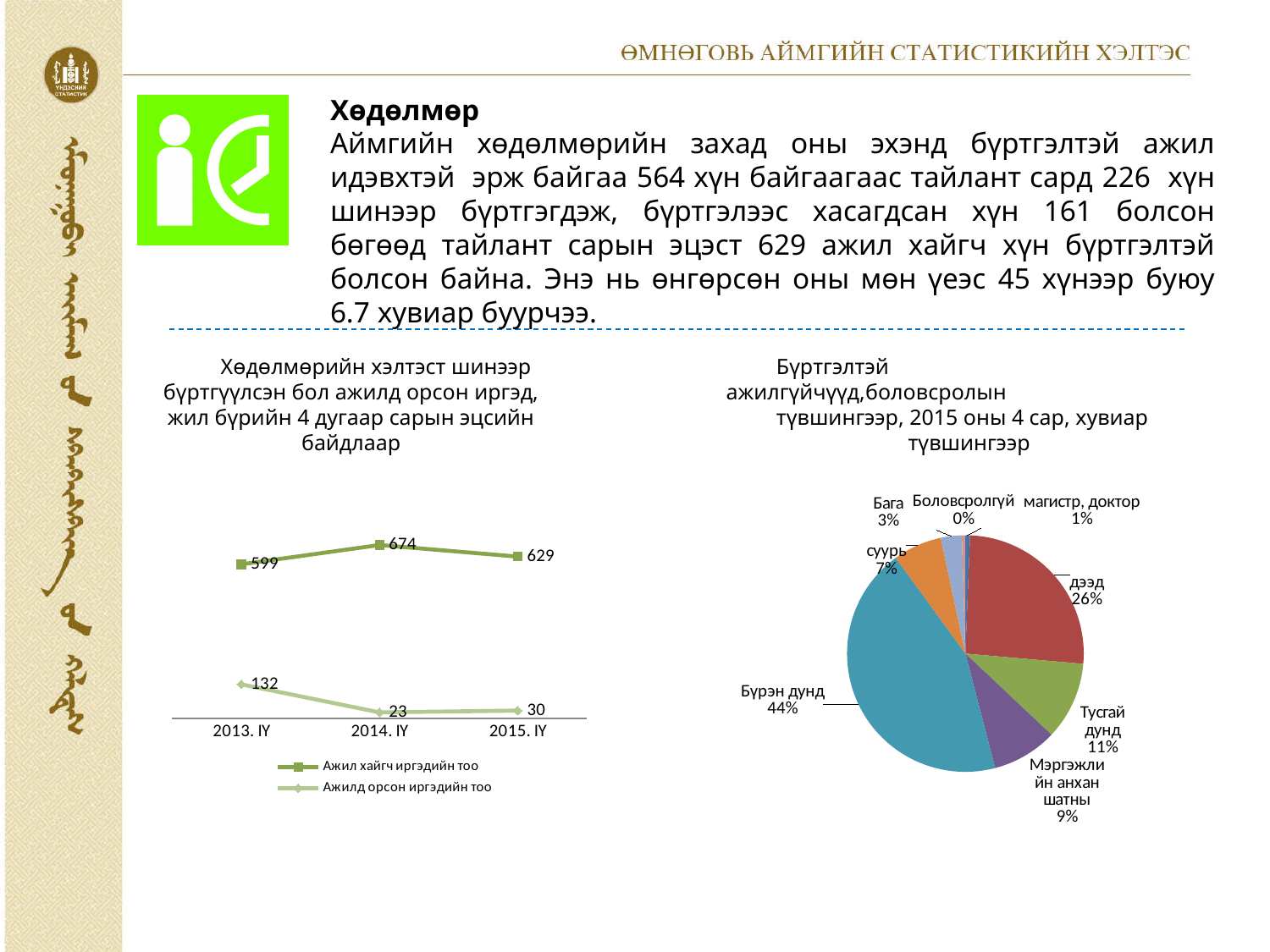
In the line chart on the left, which year has the lowest value for Ажилд орсон иргэдийн тоо? 2014. IY In the pie chart on the right, which is larger, Тусгай дунд or суурь? Тусгай дунд In the pie chart on the right, which category has the largest share? Бүрэн дунд In the line chart on the left, what is the value of Ажилд орсон иргэдийн тоо for 2013. IY? 132 In the line chart on the left, which year has the highest value for Ажил хайгч иргэдийн тоо? 2014. IY In the pie chart on the right, what share does Бүрэн дунд have? 44% In the line chart on the left, what is the difference between Ажил хайгч иргэдийн тоо in 2014. IY and 2015. IY? 45 What kind of chart is the chart on the left of the slide? line chart In the line chart on the left, how many years are shown on the x axis? 3 In the pie chart on the right, what share does дээд have? 26% In the line chart on the left, how many series does the legend list? 2 In the line chart on the left, what is the value of Ажил хайгч иргэдийн тоо for 2014. IY? 674